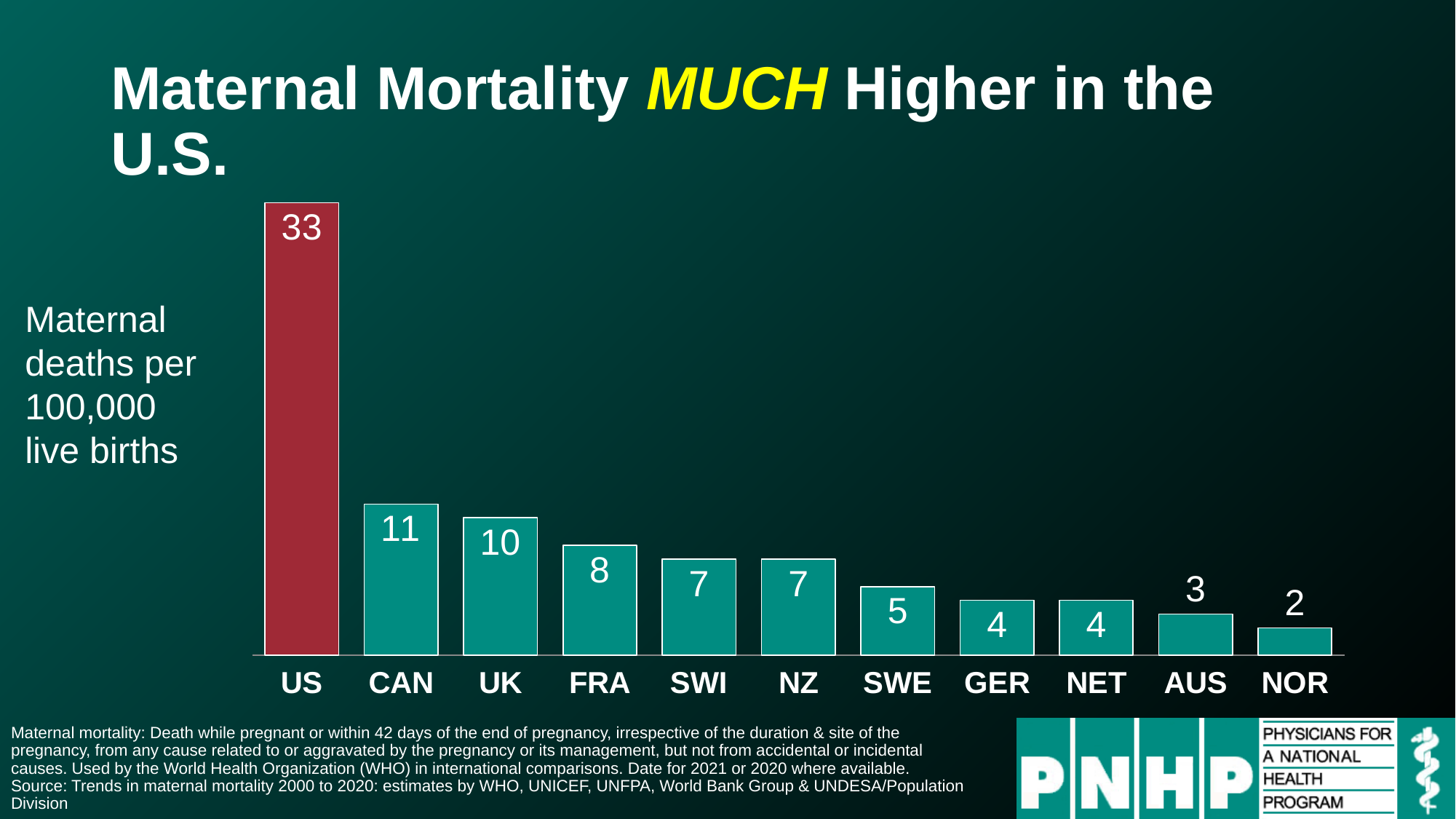
Which is larger, the value for FRA or the value for GER? FRA What is the difference between the US value and the CAN value? 22 What is the maternal mortality value for SWE? 5 Do the values rise or fall from left to right across the chart? fall How many countries are shown in the chart? 11 What is the difference between the UK value and the NOR value? 8 What is the maternal mortality value for the US? 33 Which bar is coloured differently from the others? US What kind of chart is shown on the slide? bar chart What is the maternal mortality value for CAN? 11 Which country has the lowest maternal mortality? NOR Which country has the highest maternal mortality? US